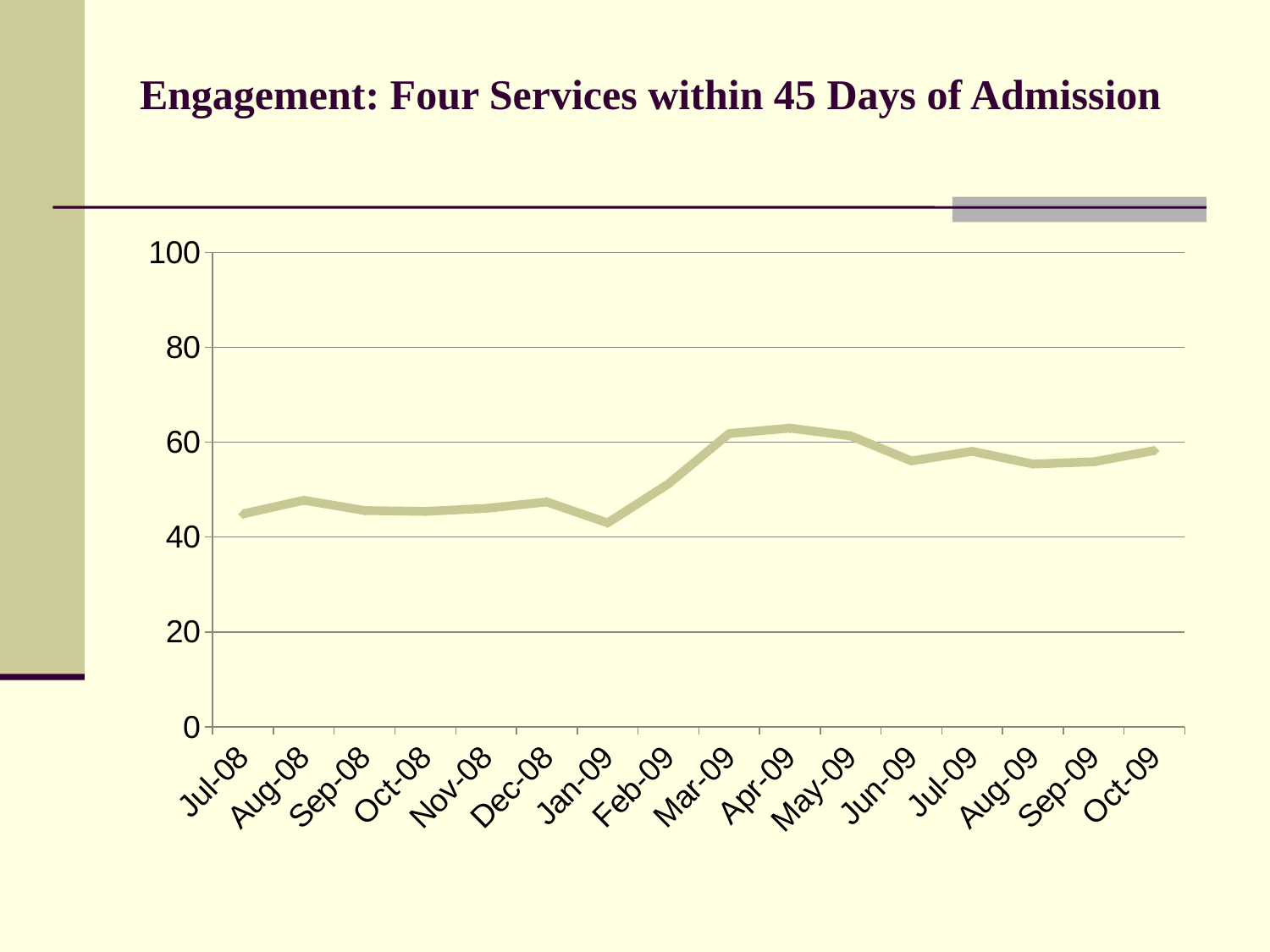
What kind of chart is shown on the slide? line chart What is the title of the chart? Engagement: Four Services within 45 Days of Admission Which is larger, the value for Apr-09 or the value for Jan-09? Apr-09 What is the first month shown on the x axis? Jul-08 Is the value for Jan-09 greater or less than 60? less Is the value for Jul-08 greater or less than 40? greater Which month has the lowest value on the chart? Jan-09 Does the line rise or fall between Jan-09 and Apr-09? rise How many months are plotted along the x axis? 16 Is the value for Apr-09 greater or less than 60? greater Which is larger, the value for Mar-09 or the value for Dec-08? Mar-09